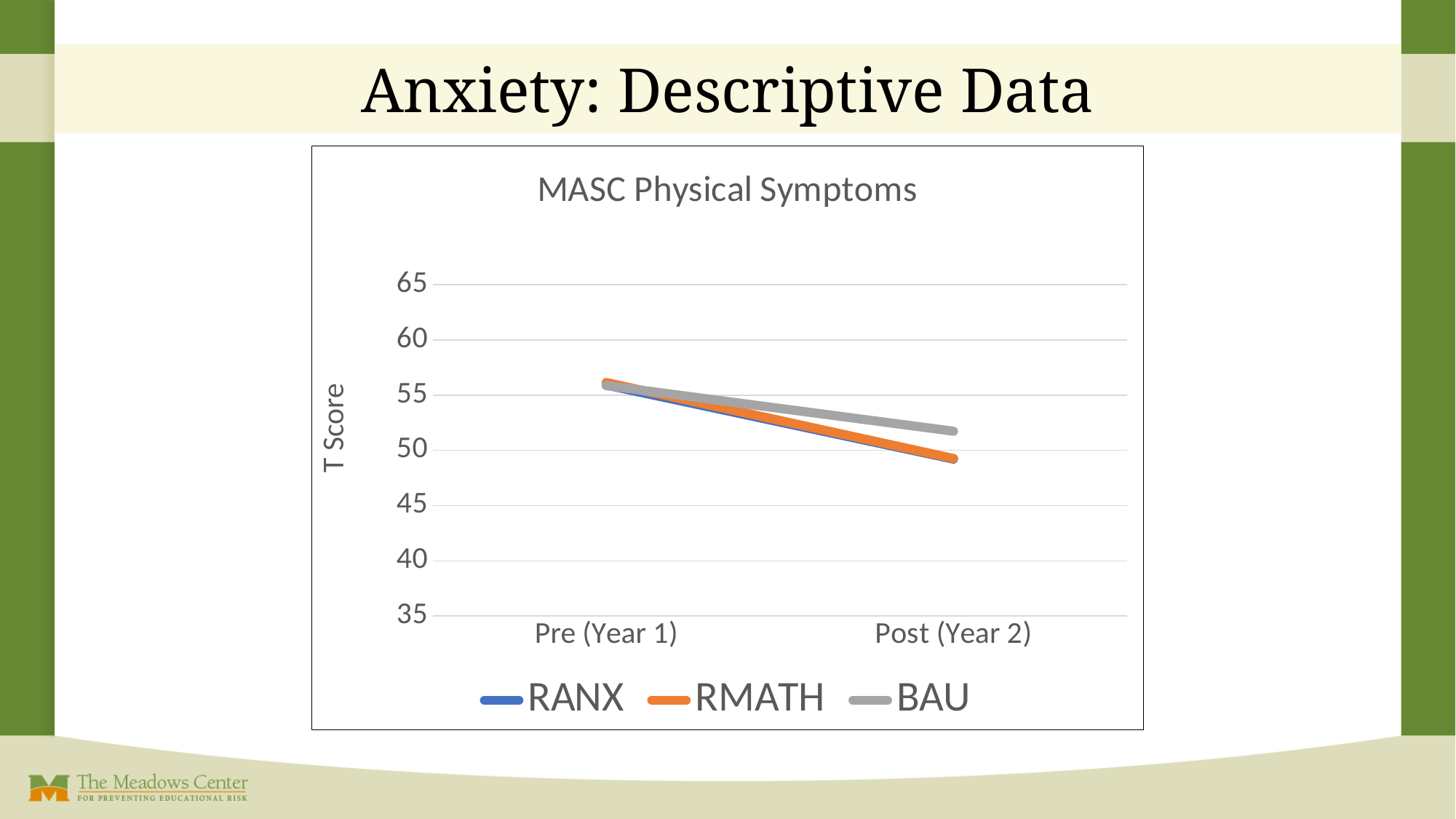
What is the label of the y axis? T Score At Post (Year 2), which is larger, the value for BAU or the value for RMATH? BAU Do the values for RMATH rise or fall from Pre (Year 1) to Post (Year 2)? fall What is the title of the chart? MASC Physical Symptoms Which series has the highest value at Post (Year 2)? BAU How many points are there along the x axis? 2 Is the value for RANX at Pre (Year 1) greater or less than 60? less Is the value for BAU at Post (Year 2) greater or less than 50? greater What kind of chart is shown on the slide? line chart Do the values for BAU rise or fall from Pre (Year 1) to Post (Year 2)? fall Is the value for RMATH at Post (Year 2) greater or less than 50? less How many series does the legend list? 3